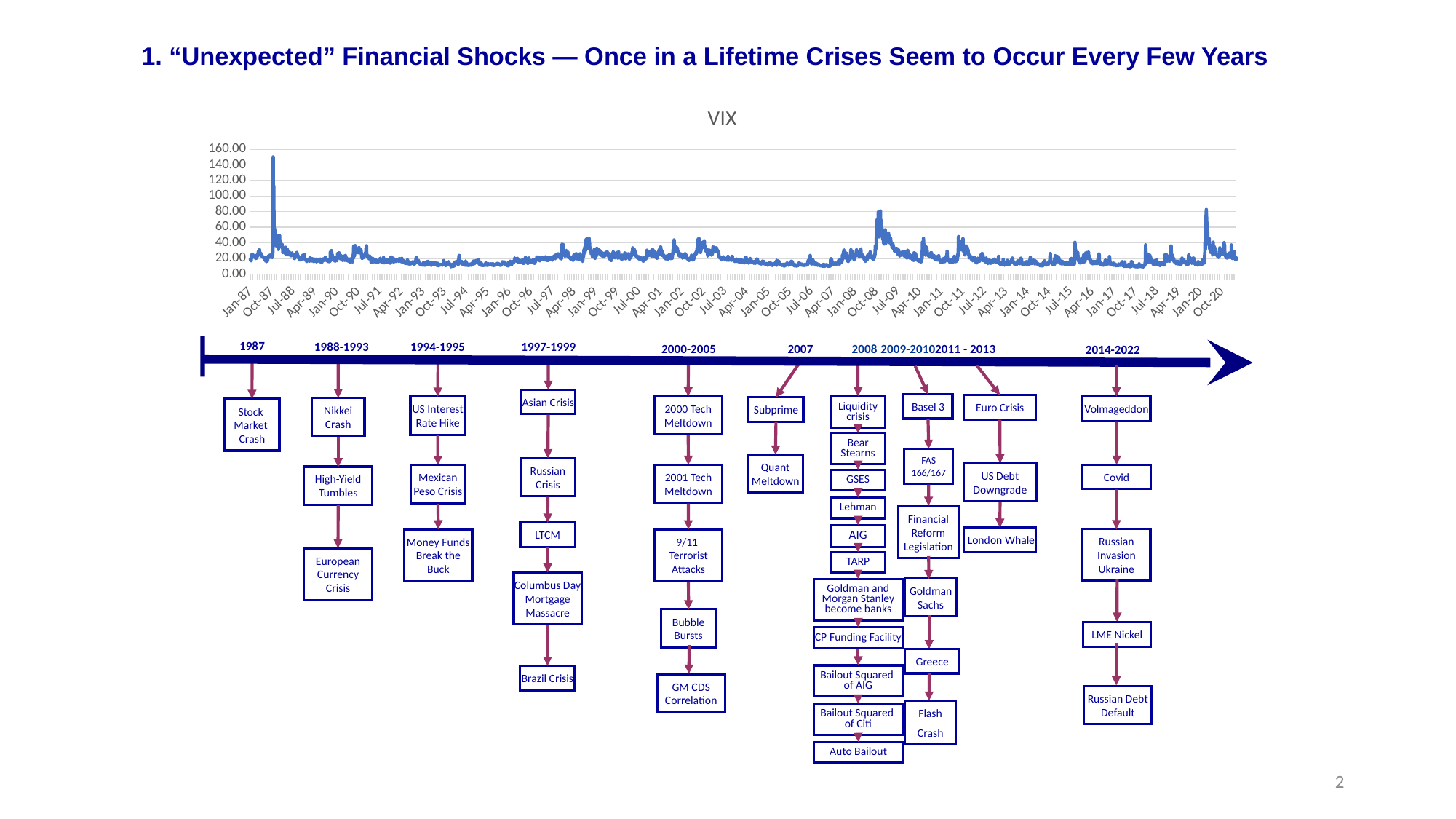
Is the VIX value around Jan-94 greater or less than 40? less Is the peak VIX value in 1987 greater or less than 140? greater What is the highest value shown on the y-axis of the VIX chart? 160.00 Is the peak VIX value around Oct-08 greater or less than 60? greater What type of chart is shown on the slide? line chart Which is larger: the VIX peak around Oct-87 or the VIX peak around Oct-08? Oct-87 Which is larger: the VIX peak around Oct-08 or the VIX peak around Apr-98? Oct-08 How many data series are plotted in the VIX chart? 1 Around which x-axis label does the VIX reach its highest value? Oct-87 What is the title of the chart? VIX